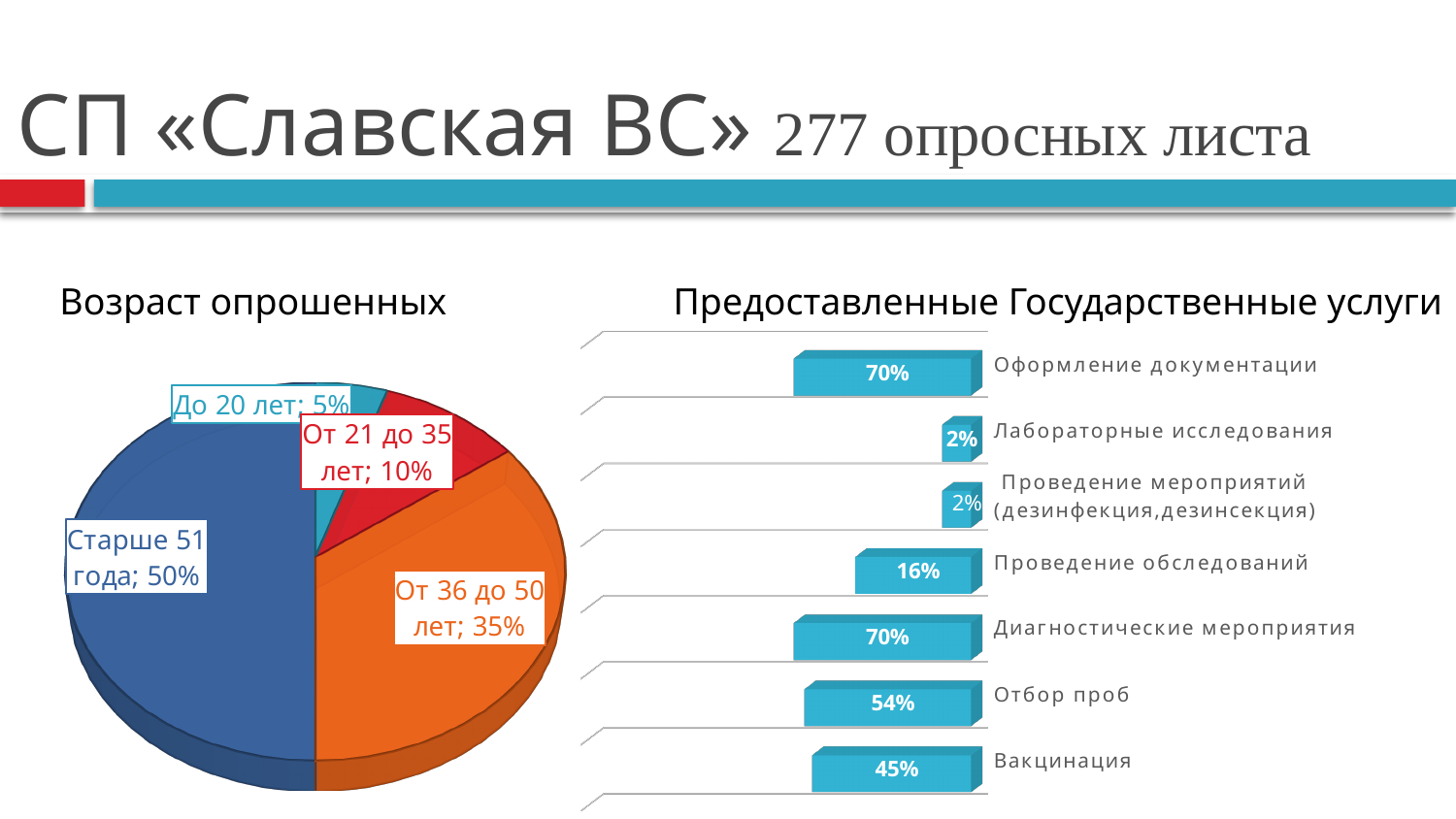
In the chart 'Предоставленные Государственные услуги', what is the value for 'Проведение обследований'? 16% In the pie chart 'Возраст опрошенных', which age group has the smallest share? До 20 лет In the pie chart 'Возраст опрошенных', how many slices are there? 4 In the pie chart 'Возраст опрошенных', which age group has the largest share? Старше 51 года In the pie chart 'Возраст опрошенных', what is the value for 'От 36 до 50 лет'? 35% What type of chart is 'Предоставленные Государственные услуги'? Bar chart In the chart 'Предоставленные Государственные услуги', what is the difference between 'Оформление документации' and 'Вакцинация'? 25% In the chart 'Предоставленные Государственные услуги', what is the value for 'Отбор проб'? 54% In the pie chart 'Возраст опрошенных', what share of respondents are 'Старше 51 года'? 50% In the chart 'Предоставленные Государственные услуги', which is larger: 'Отбор проб' or 'Вакцинация'? Отбор проб In the chart 'Предоставленные Государственные услуги', how many categories are shown? 7 In the pie chart 'Возраст опрошенных', what is the difference between 'От 36 до 50 лет' and 'От 21 до 35 лет'? 25%